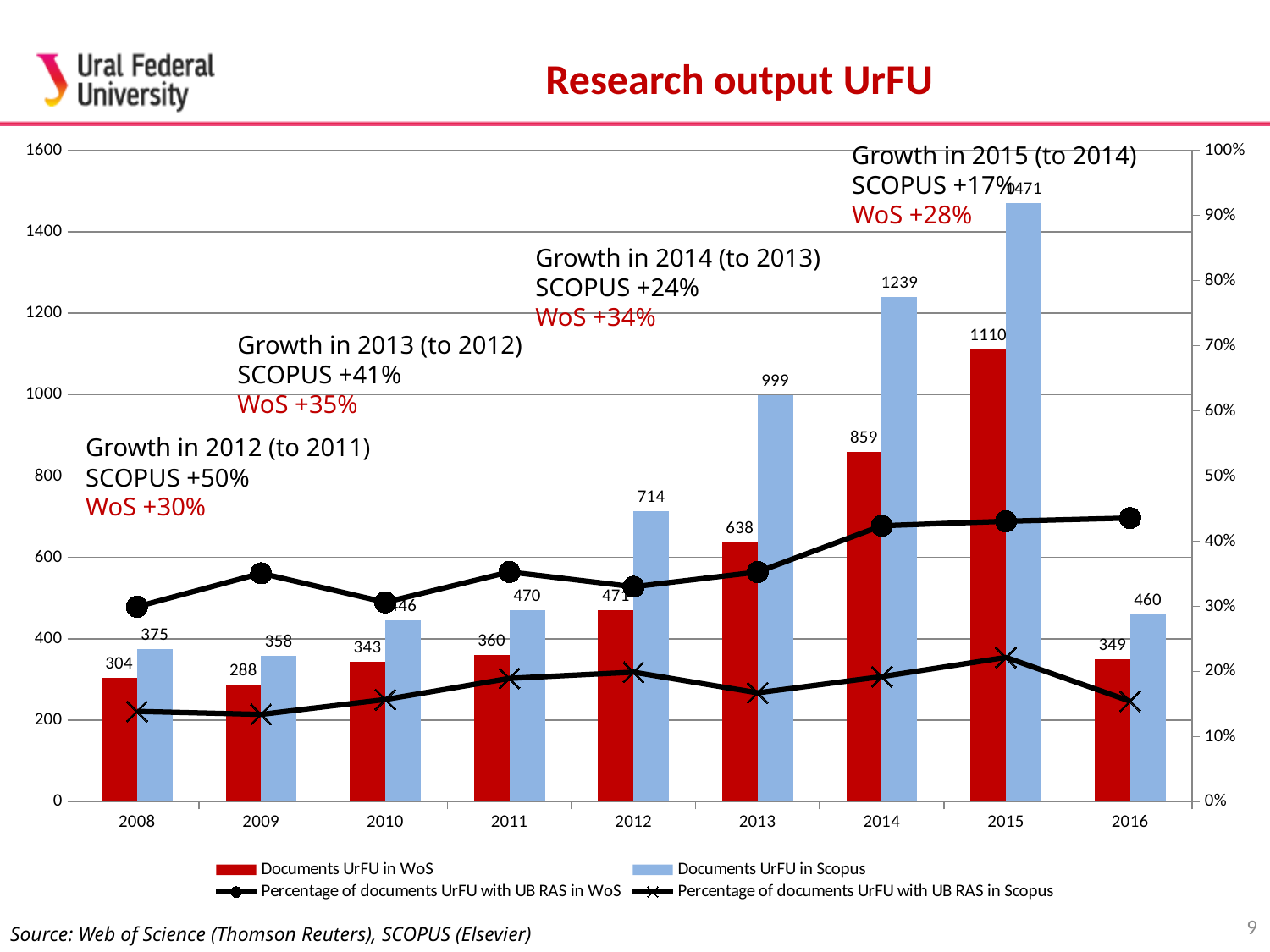
In which year is the number of documents UrFU in Scopus highest? 2015 In which year is the number of documents UrFU in WoS lowest? 2009 What is the number of documents UrFU in Scopus for 2013? 999 How many documents did UrFU have in WoS in 2014? 859 What is the combined number of WoS and Scopus documents in 2012? 1185 From 2009 to 2015, do the documents UrFU in WoS rise or fall? rise How many series does the legend list? 4 In 2015, which is larger: documents UrFU in WoS or documents UrFU in Scopus? Documents UrFU in Scopus Is the percentage of documents UrFU with UB RAS in Scopus in 2008 greater or less than 20%? less What kind of chart is shown on the slide? Bar chart with line series What is the difference between the Scopus and WoS document counts in 2014? 380 How many years are shown on the x axis? 9